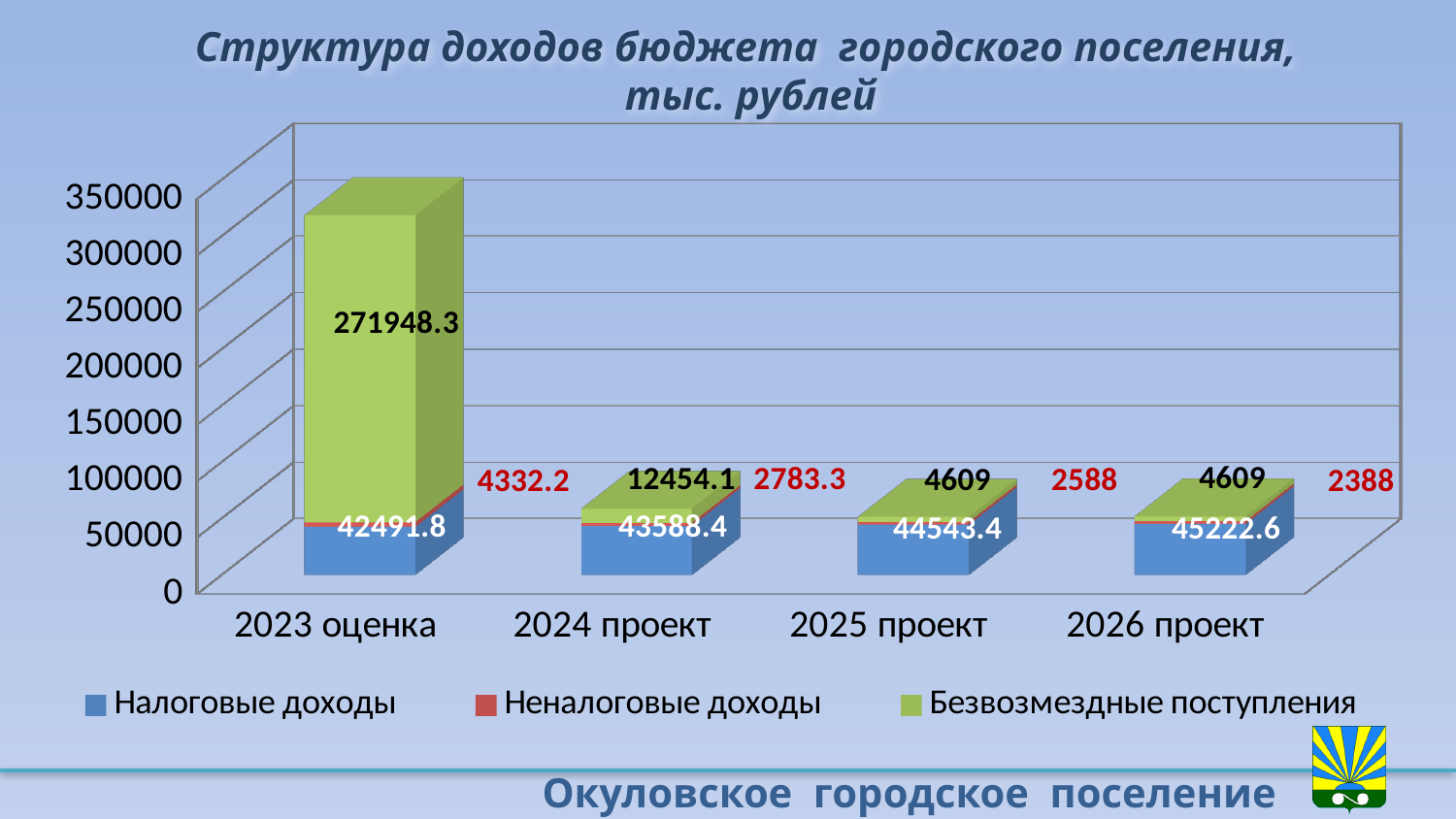
What is the value of Налоговые доходы for 2023 оценка? 42491.8 What is the value of Неналоговые доходы for 2026 проект? 2388 What is the difference between Налоговые доходы for 2026 проект and 2023 оценка? 2730.8 Which category has the highest value of Безвозмездные поступления? 2023 оценка How many categories are shown on the x axis? 4 Which category has the lowest value of Налоговые доходы? 2023 оценка Do the values of Налоговые доходы rise or fall from 2023 оценка to 2026 проект? Rise What kind of chart is shown on the slide? Stacked bar chart What is the value of Безвозмездные поступления for 2024 проект? 12454.1 Which is larger: Неналоговые доходы for 2024 проект or for 2025 проект? 2024 проект How many series does the legend list? 3 What is the total of the stacked bar for 2025 проект? 51740.4